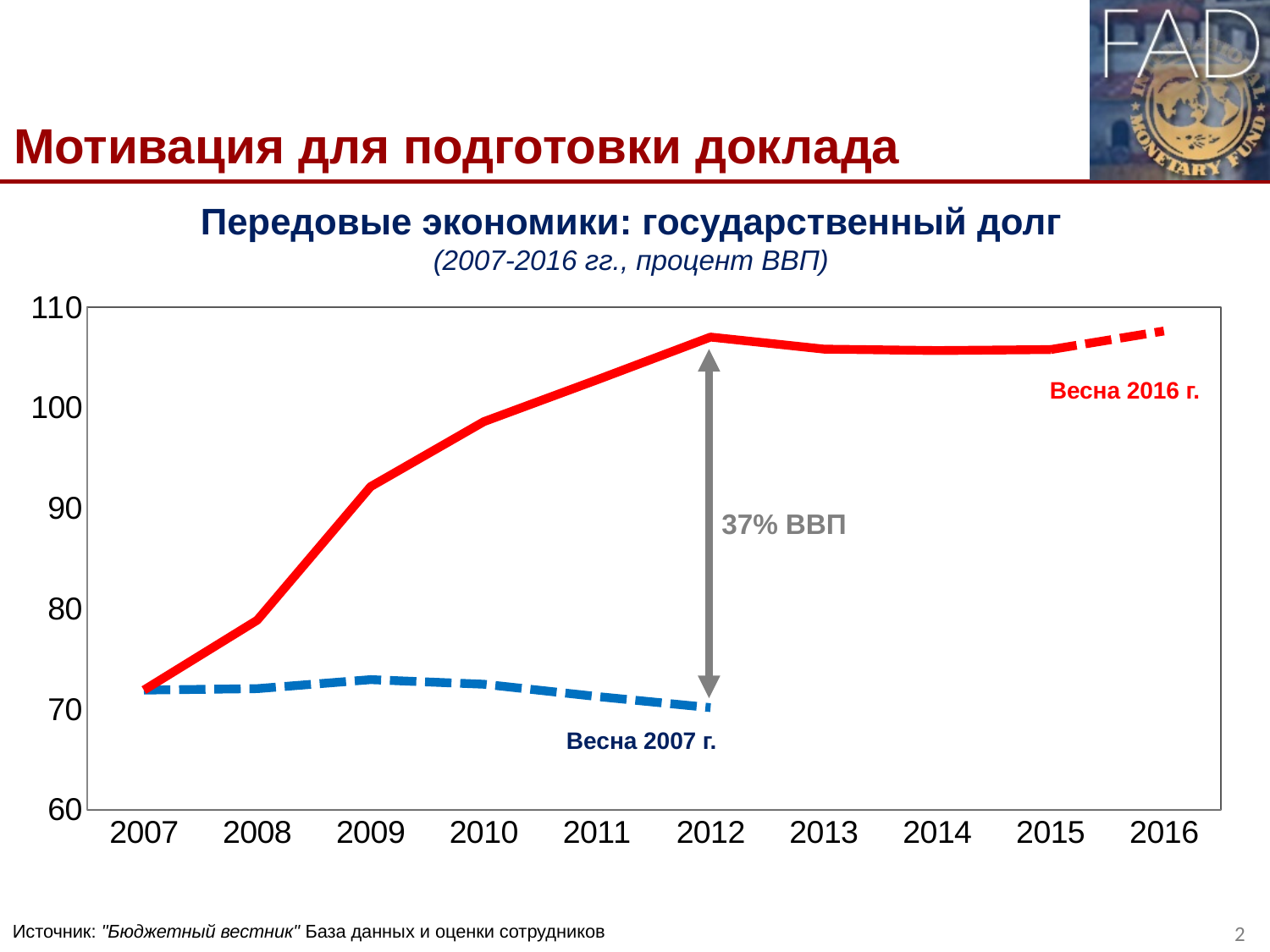
What gap between the two lines is annotated for 2012? 37% ВВП What is the title of the chart? Передовые экономики: государственный долг In 2012, which series has the higher value, 'Весна 2016 г.' or 'Весна 2007 г.'? Весна 2016 г. Is the value of the 'Весна 2007 г.' line in 2012 greater or less than 80? less How many series are plotted on the chart? 2 Does the 'Весна 2016 г.' line rise or fall from 2007 to 2012? rise How many years are shown on the x axis of the chart? 10 In which year is the 'Весна 2016 г.' line at its lowest? 2007 Is the value of the 'Весна 2016 г.' line in 2010 greater or less than 90? greater Is the value of the 'Весна 2016 г.' line in 2007 greater or less than 80? less What kind of chart is shown on the slide? line chart